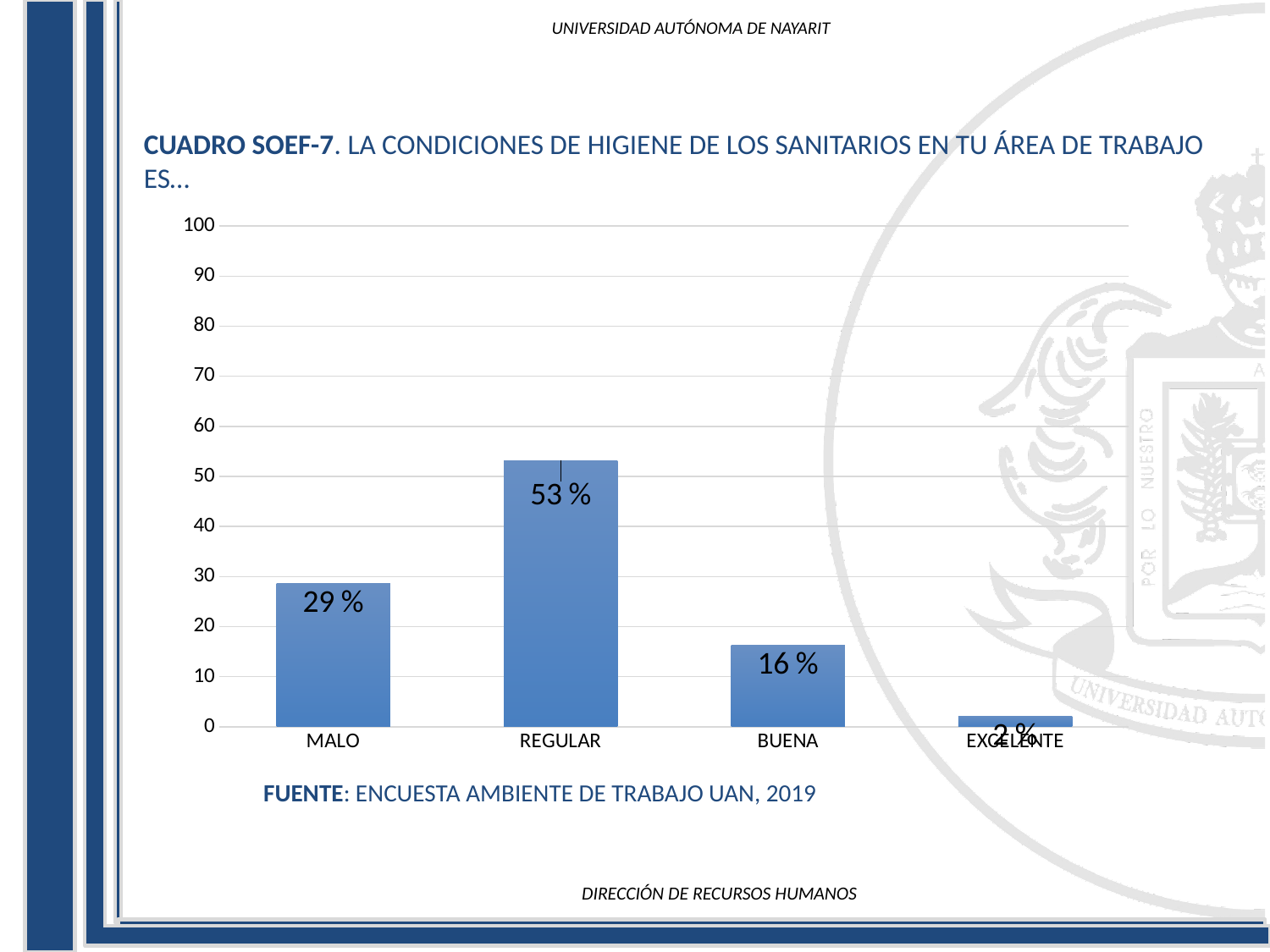
What is the difference between the values for MALO and BUENA? 13 % What is the difference between the values for REGULAR and MALO? 24 % What is the value shown for REGULAR? 53 % Which category has the lowest value? EXCELENTE What is the value shown for BUENA? 16 % What is the value shown for MALO? 29 % Which is larger, the value for MALO or the value for BUENA? MALO What kind of chart is shown on the slide? bar chart What source is cited below the chart? ENCUESTA AMBIENTE DE TRABAJO UAN, 2019 How many categories are shown on the x axis? 4 Is the value for EXCELENTE greater or less than 10? less Which category has the highest value? REGULAR